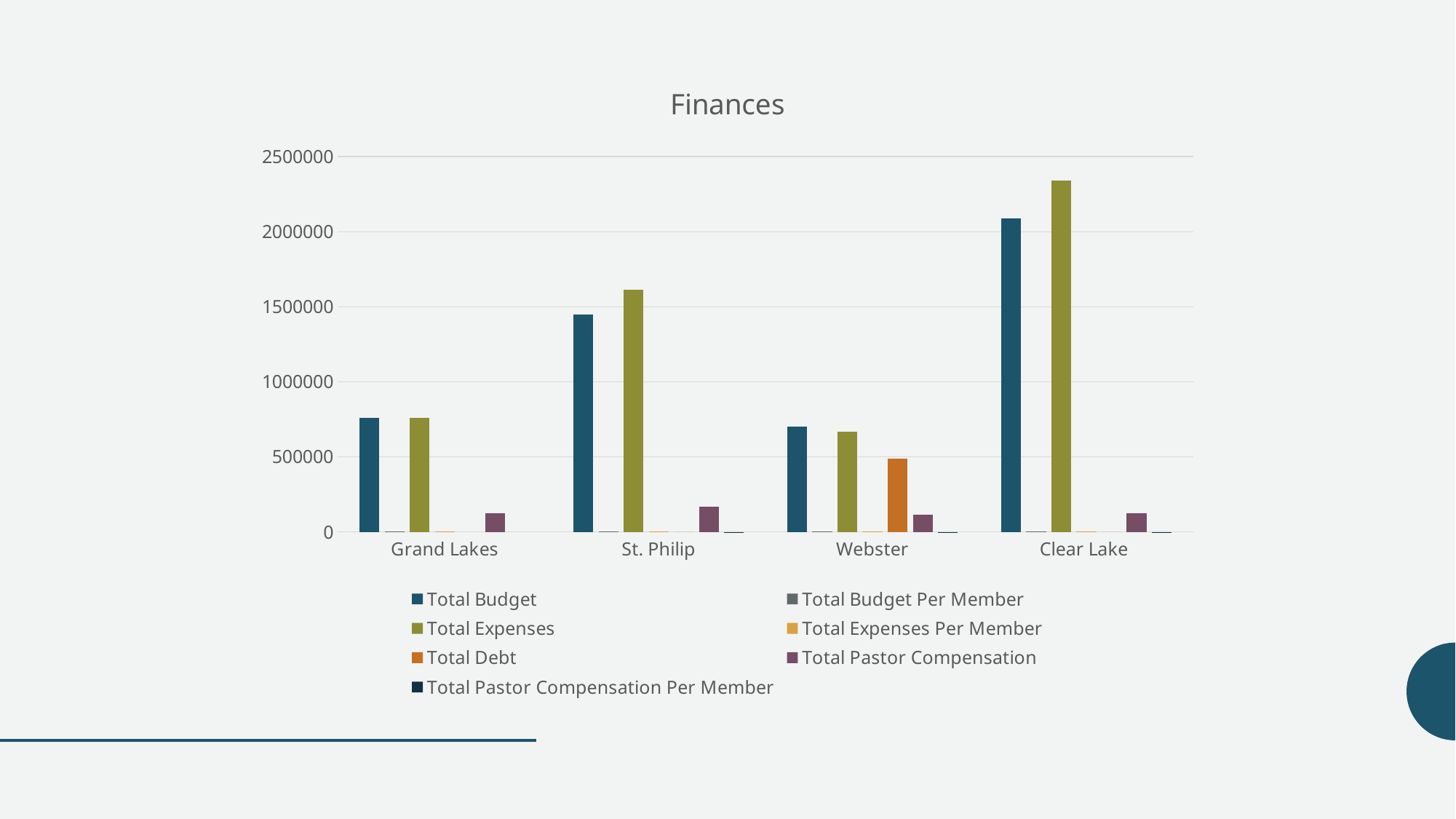
Which church has the highest Total Budget? Clear Lake Which church has the highest Total Debt? Webster How many series does the legend list? 7 For Clear Lake, which is larger: Total Budget or Total Expenses? Total Expenses What kind of chart is shown on the slide? Bar chart What is the title of the chart? Finances Is the Total Expenses value for St. Philip greater or less than 1500000? greater Is the Total Budget for Grand Lakes greater or less than 1000000? less Which church has the lowest Total Expenses? Webster Which has a larger Total Budget: St. Philip or Webster? St. Philip How many churches (categories) are shown on the x axis? 4 Is the Total Budget for Clear Lake greater or less than 2000000? greater